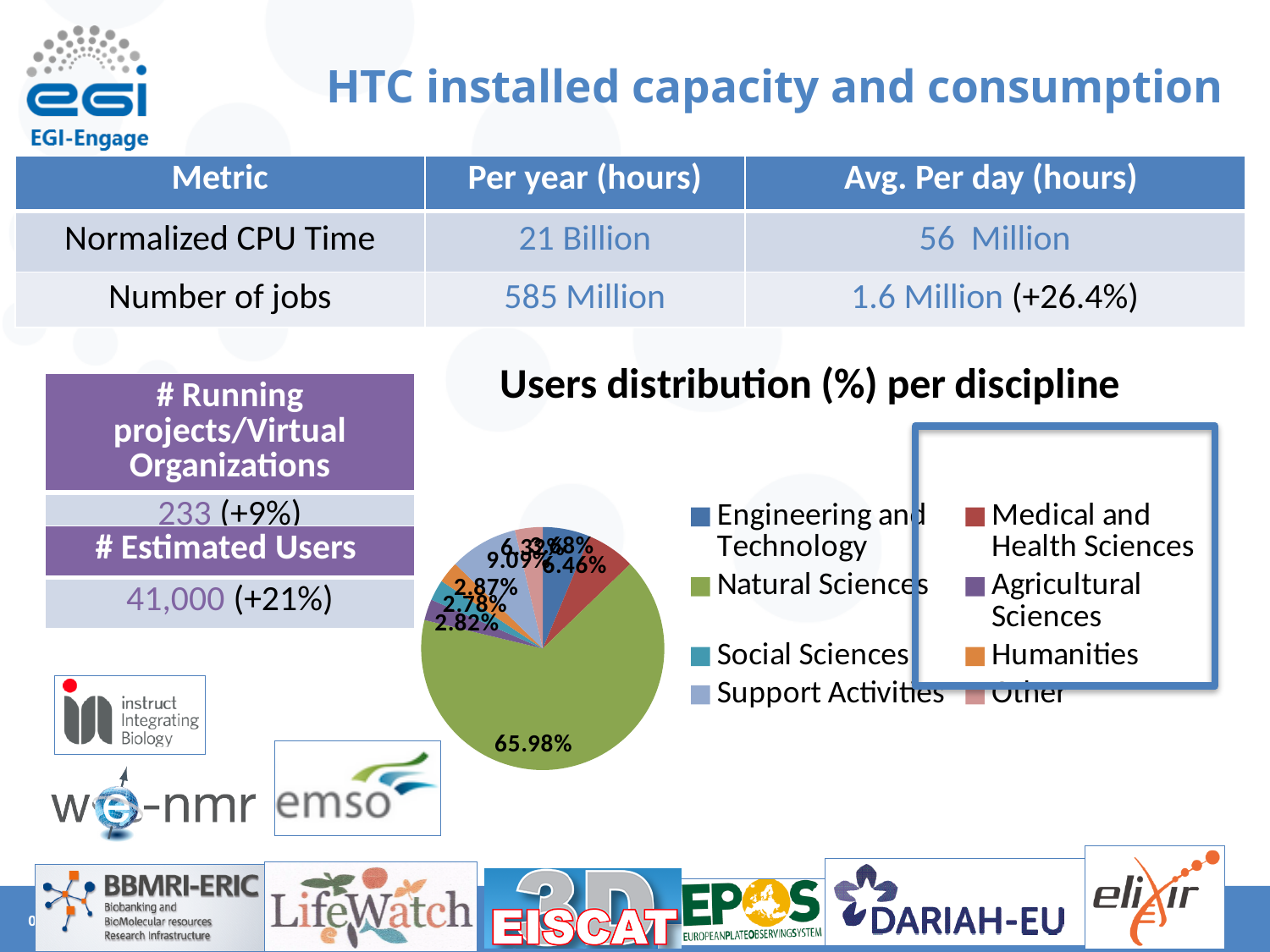
In the 'Users distribution (%) per discipline' pie chart, which is larger: the Natural Sciences slice or the Medical and Health Sciences slice? Natural Sciences What kind of chart is shown under the heading 'Users distribution (%) per discipline'? pie chart In the 'Users distribution (%) per discipline' pie chart, which discipline has the largest slice? Natural Sciences In the 'Users distribution (%) per discipline' pie chart, is the share for Natural Sciences greater or less than 50%? greater How many disciplines does the legend of the 'Users distribution (%) per discipline' pie chart list? 8 What is the title of the pie chart on the slide? Users distribution (%) per discipline In the 'Users distribution (%) per discipline' pie chart, what colour represents Natural Sciences? green In the 'Users distribution (%) per discipline' pie chart, is the share for Natural Sciences greater or less than 70%? less In the 'Users distribution (%) per discipline' pie chart, what share do Natural Sciences have? 65.98%